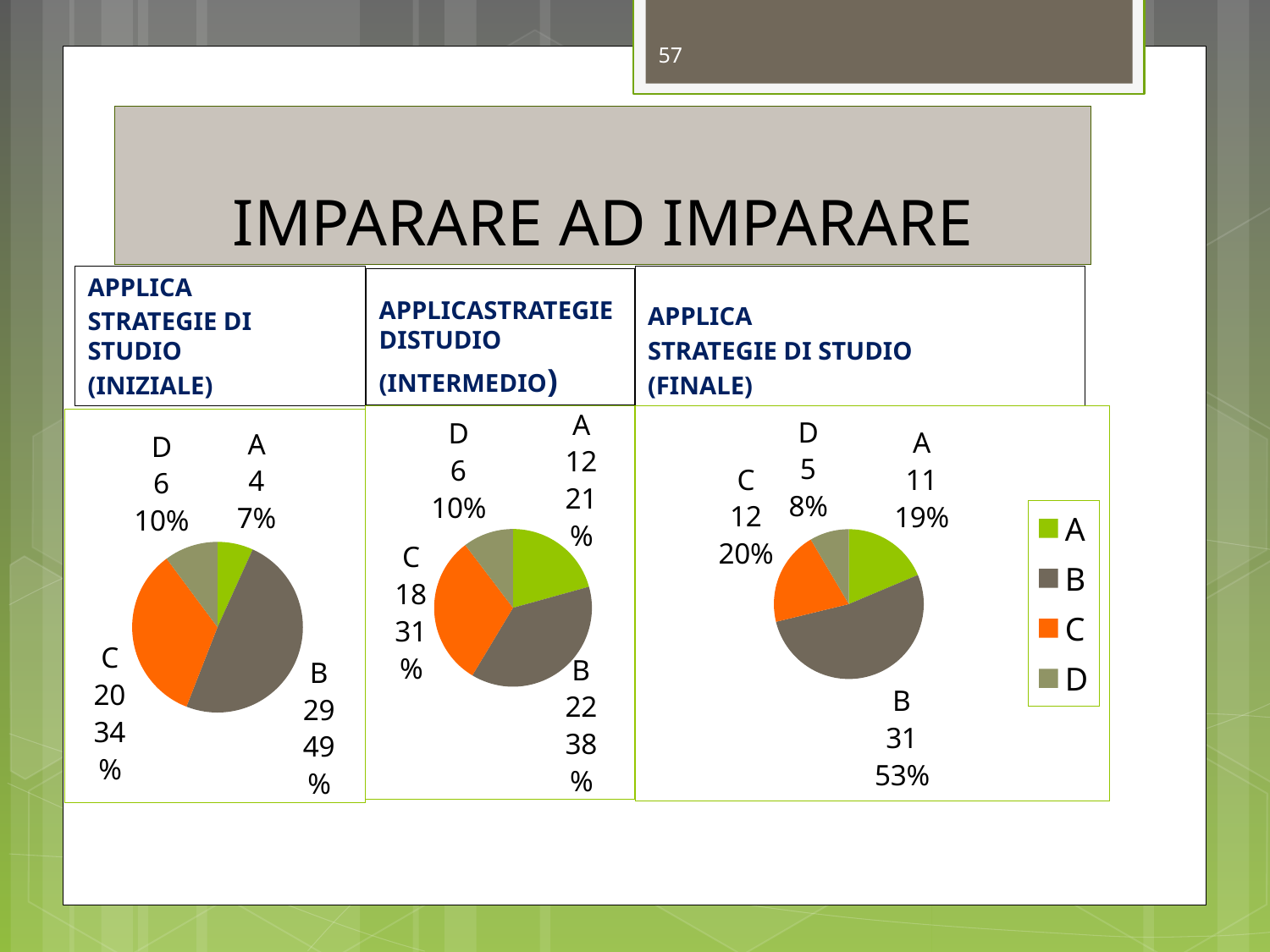
In the INIZIALE pie chart, which category has the smallest share? A What kind of chart is used for the INIZIALE, INTERMEDIO and FINALE data? Pie chart In the INTERMEDIO pie chart, which category has the largest share? B How many categories does the legend on the slide list? 4 How many pie charts are shown on the slide? 3 In the INTERMEDIO pie chart, what is the difference between the counts for B and A? 10 In the INIZIALE pie chart, what is the count shown for category C? 20 In the FINALE pie chart, which is larger, the share for A or the share for D? A In the INTERMEDIO pie chart, what percentage share does category C have? 31% In the FINALE pie chart, what is the count shown for category B? 31 In the FINALE pie chart, what percentage share does category D have? 8% In the INIZIALE pie chart, what percentage share does category B have? 49%